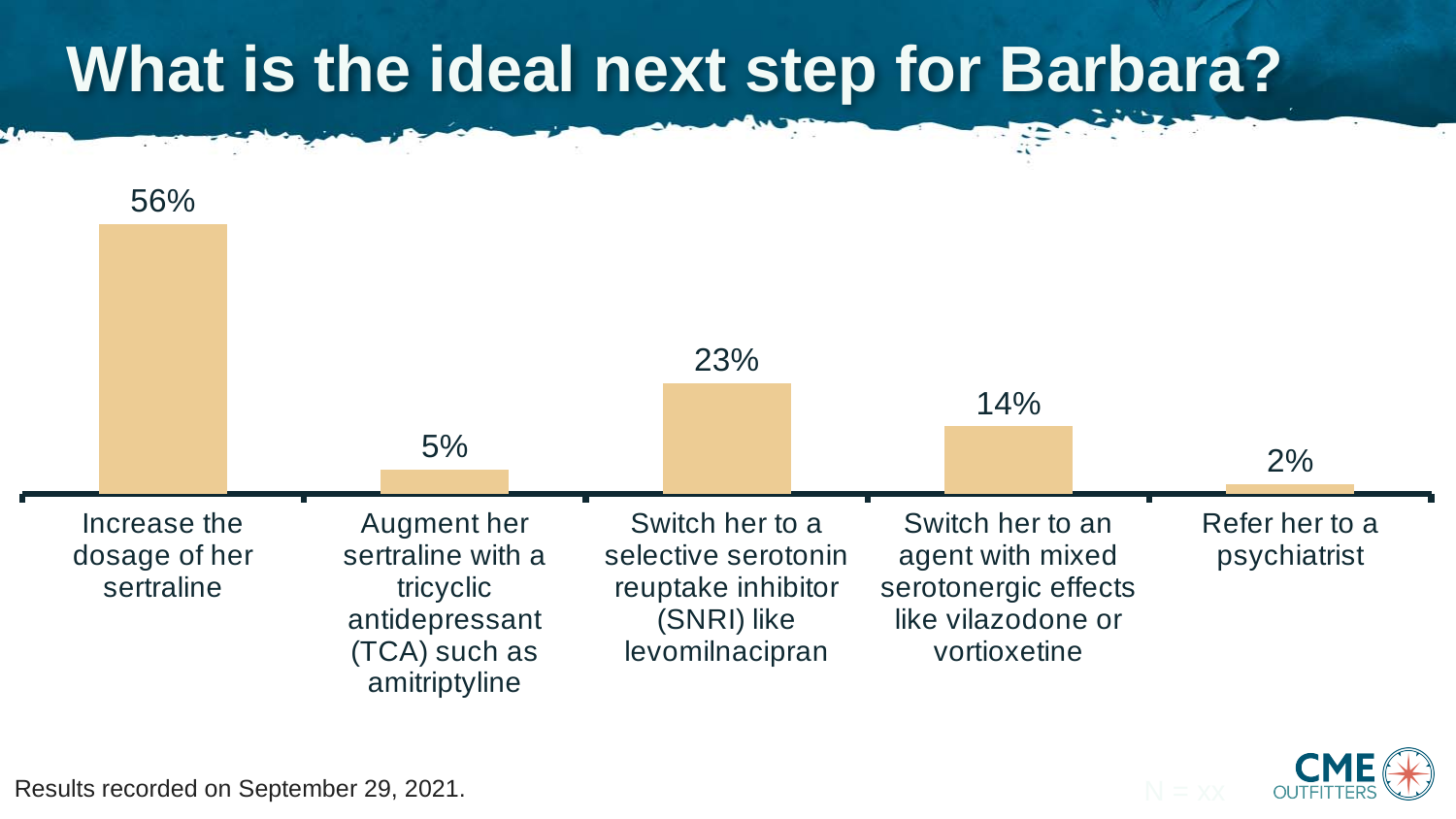
What percentage of respondents chose "Refer her to a psychiatrist"? 2% What is the value for "Switch her to a selective serotonin reuptake inhibitor (SNRI) like levomilnacipran"? 23% How many response options are shown in the chart? 5 What is the difference between the values for "Switch her to an agent with mixed serotonergic effects like vilazodone or vortioxetine" and "Augment her sertraline with a tricyclic antidepressant (TCA) such as amitriptyline"? 9 percentage points What is the difference in percentage points between "Increase the dosage of her sertraline" and "Switch her to a selective serotonin reuptake inhibitor (SNRI) like levomilnacipran"? 33 percentage points What type of chart is shown on the slide? Bar chart Which option received the lowest percentage of responses? Refer her to a psychiatrist What percentage of respondents chose "Increase the dosage of her sertraline"? 56% What is the title of the slide? What is the ideal next step for Barbara? Which option received the highest percentage of responses? Increase the dosage of her sertraline Which received a larger share of responses: switching to an SNRI or switching to an agent with mixed serotonergic effects? Switching to an SNRI What is the value for "Augment her sertraline with a tricyclic antidepressant (TCA) such as amitriptyline"? 5%